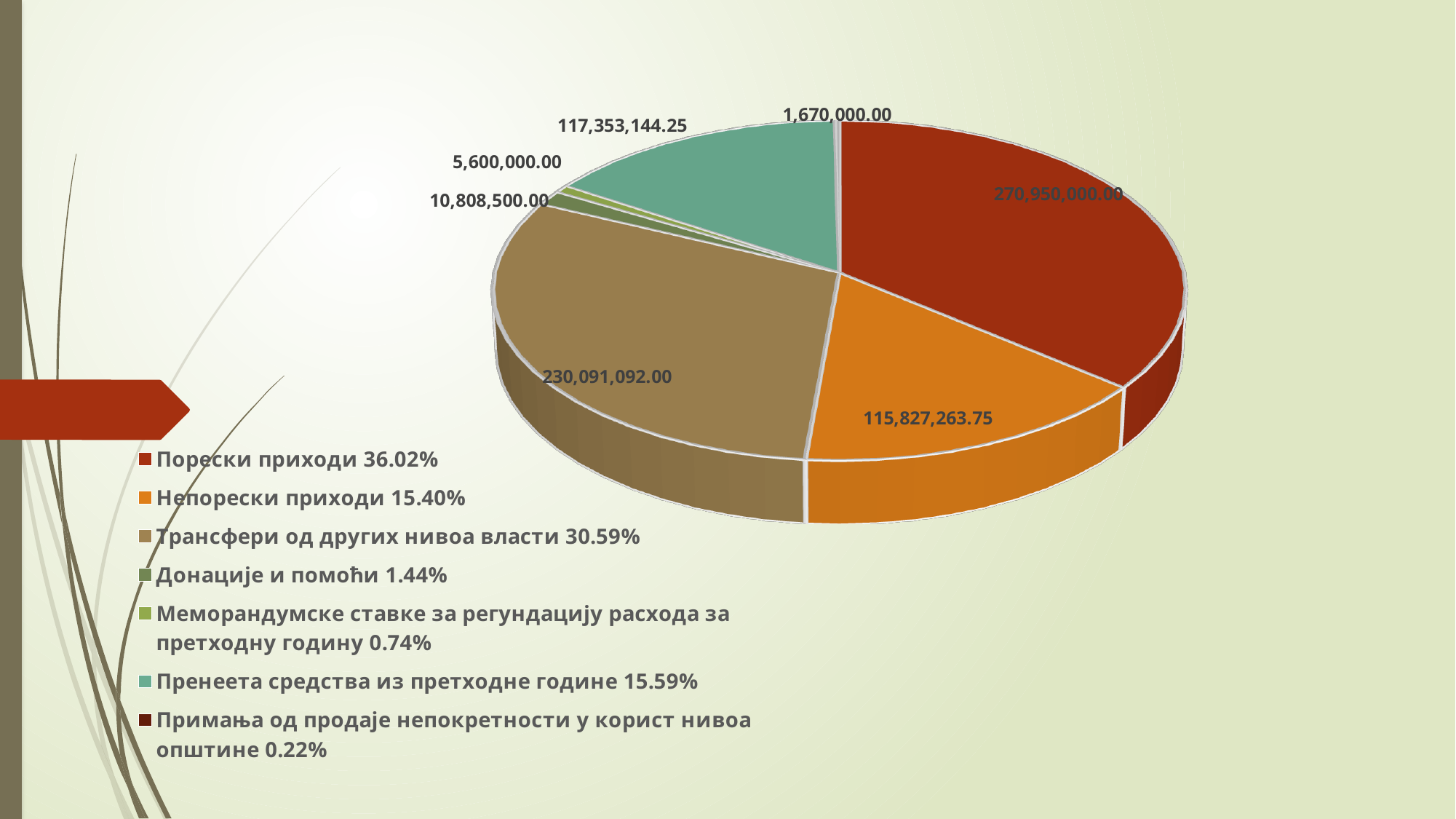
What is the value shown for Порески приходи? 270,950,000.00 What is the value shown for Трансфери од других нивоа власти? 230,091,092.00 How many categories does the legend of the pie chart list? 7 Which is larger, the value for Непорески приходи or the value for Донације и помоћи? Непорески приходи What share of the pie does Меморандумске ставке за регундацију расхода за претходну годину represent, according to the legend? 0.74% What is the value shown for Пренеета средства из претходне године? 117,353,144.25 Which category has the smallest slice of the pie? Примања од продаје непокретности у корист нивоа општине What is the value shown for Донације и помоћи? 10,808,500.00 What share of the pie does Трансфери од других нивоа власти represent, according to the legend? 30.59% What type of chart is shown on the slide? Pie chart What is the difference between the values for Порески приходи and Трансфери од других нивоа власти? 40,858,908.00 Which category has the largest slice of the pie? Порески приходи